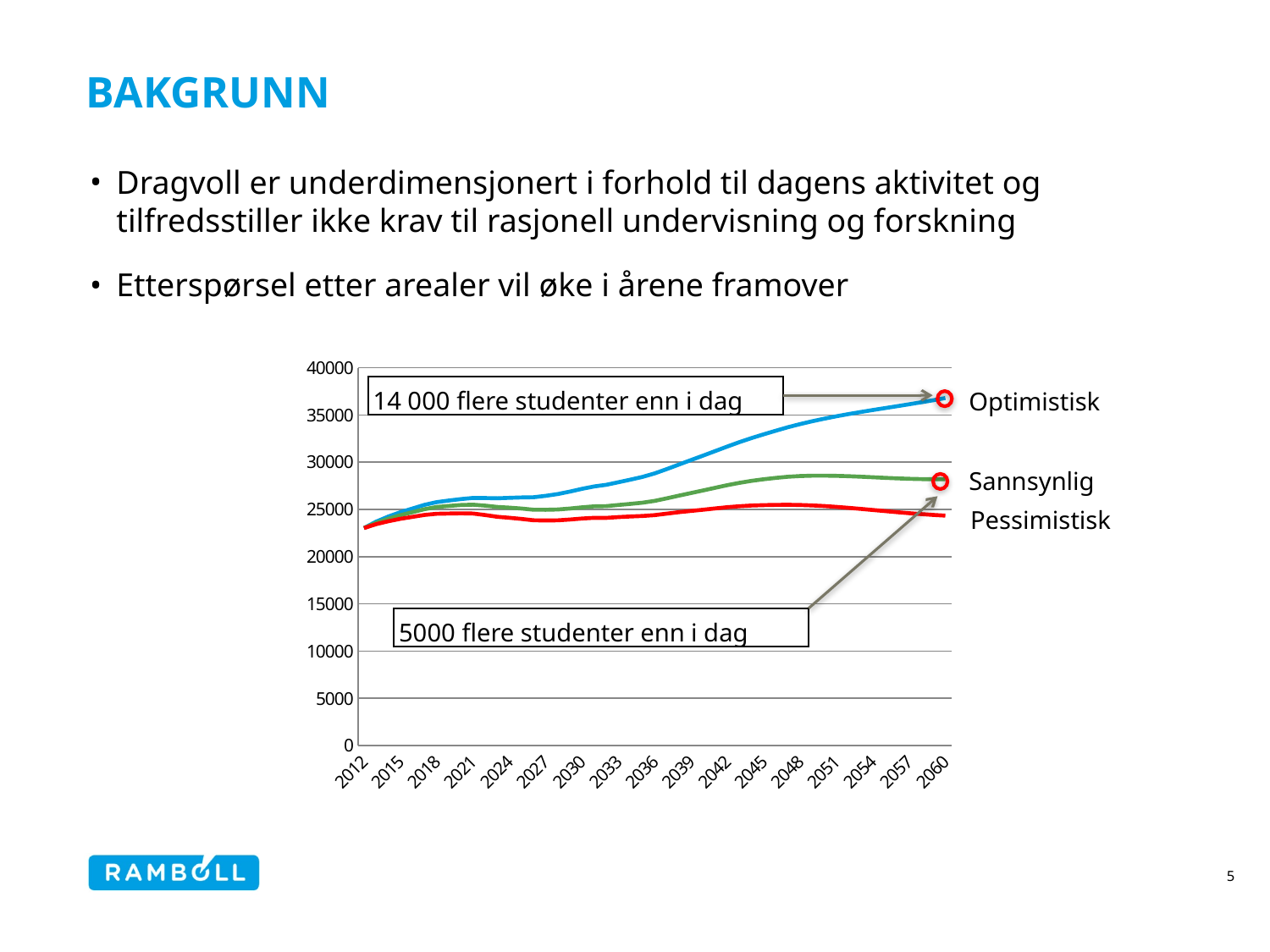
Which series has the lowest value in 2060? Pessimistisk In 2060, which is larger: the Sannsynlig value or the Pessimistisk value? Sannsynlig How many year labels are shown on the x axis? 17 Is the value for Pessimistisk in 2060 greater or less than 30000? less What kind of chart is shown on the slide? line chart Which series has the highest value in 2060? Optimistisk Is the starting value of the series in 2012 greater or less than 25000? less What does the annotation pointing to the Optimistisk line in 2060 say? 14 000 flere studenter enn i dag Is the value for Sannsynlig in 2060 greater or less than 30000? less How many series (scenarios) are plotted in the chart? 3 Does the Optimistisk series rise or fall from 2012 to 2060? rise